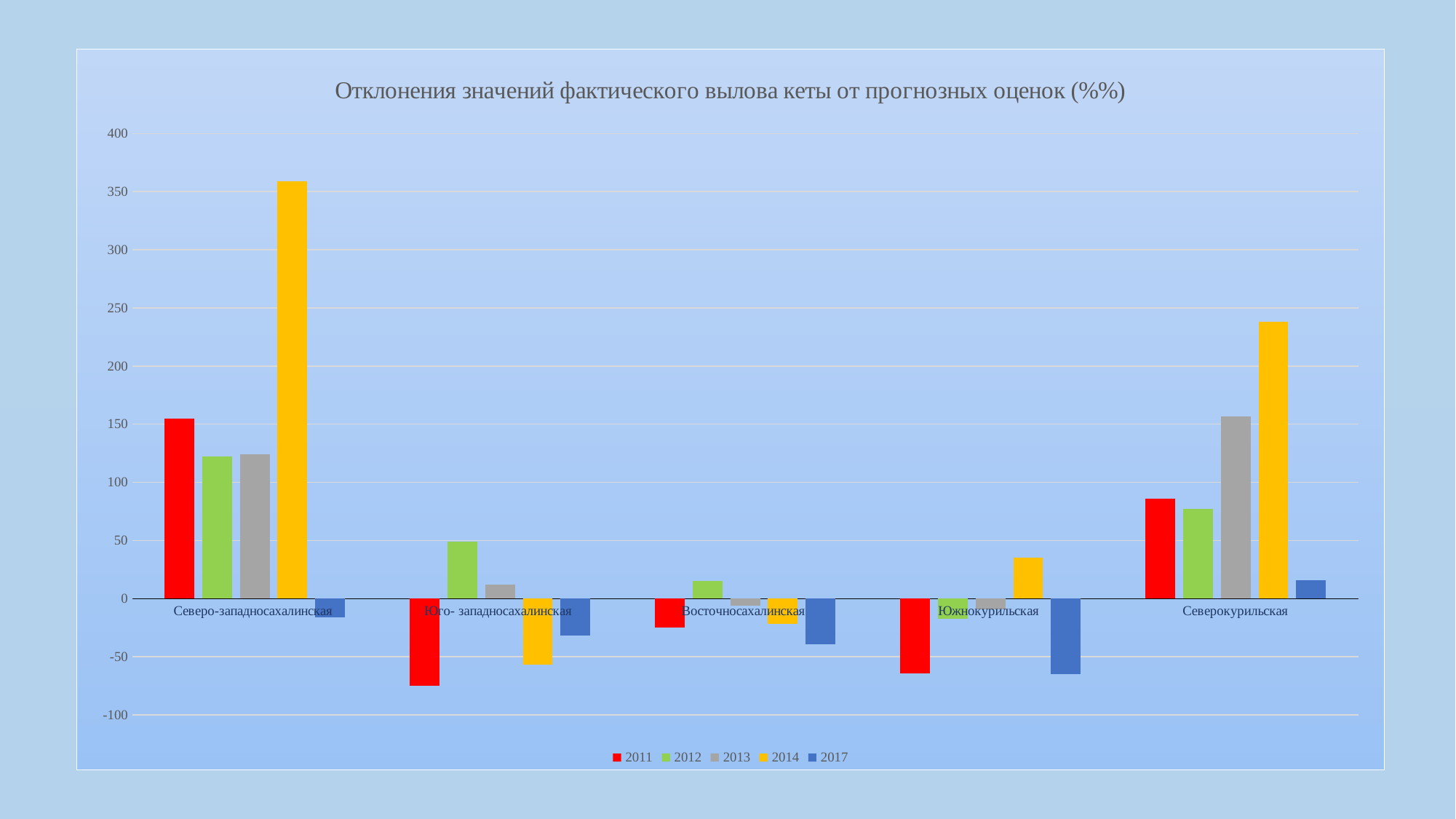
Which is larger for Юго- западносахалинская: the 2012 value or the 2013 value? 2012 What is the title of the chart? Отклонения значений фактического вылова кеты от прогнозных оценок (%%) How many categories are shown on the x axis? 5 Is the 2014 value for Северокурильская greater or less than 200? greater Is the 2011 value for Северо-западносахалинская greater or less than 100? greater What kind of chart is shown on the slide? bar chart Is the 2011 value for Юго- западносахалинская greater or less than -50? less Which is larger for Северокурильская: the 2013 value or the 2012 value? 2013 Which series has the highest value for Северо-западносахалинская? 2014 How many series does the legend list? 5